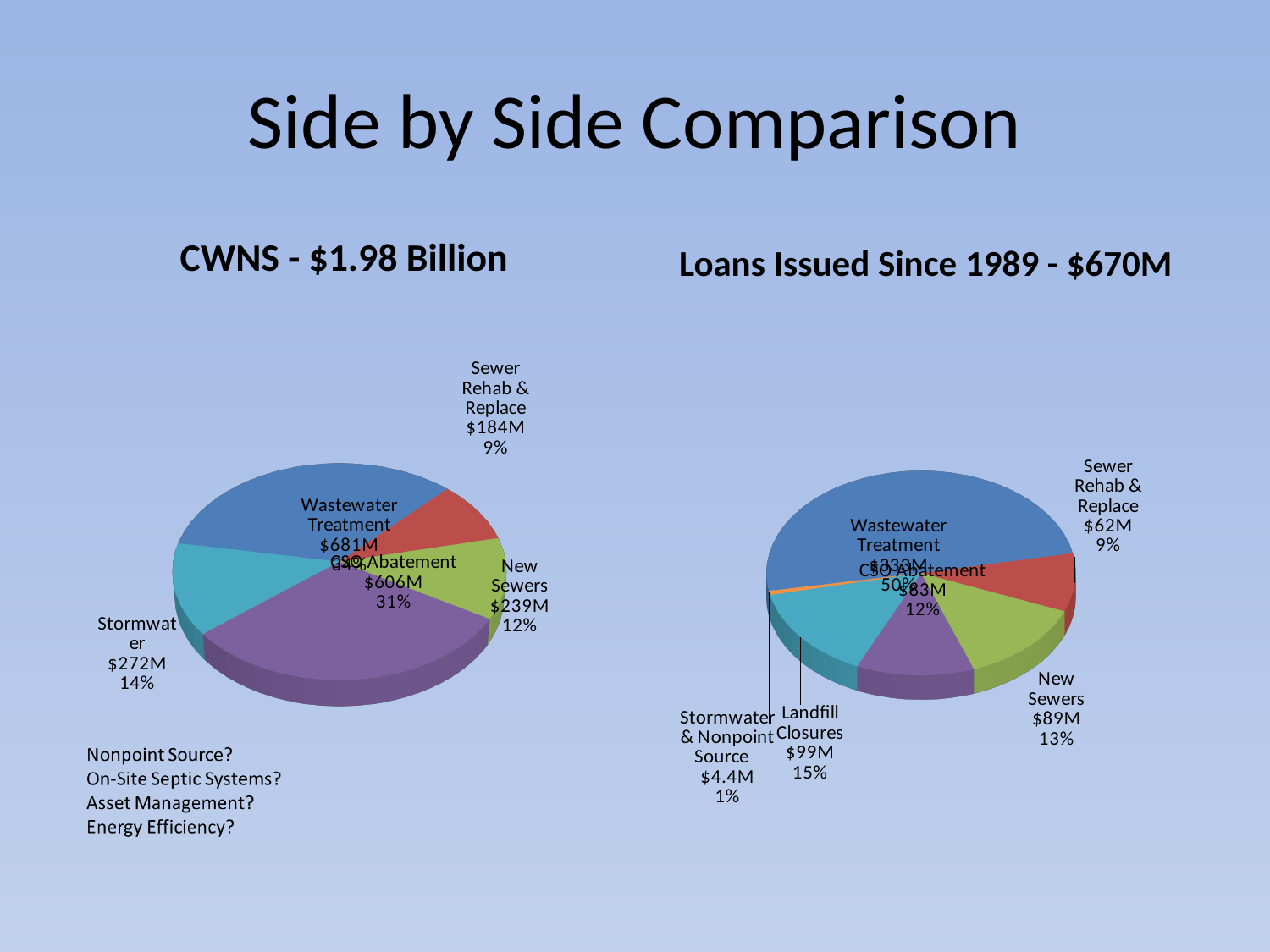
What is the difference between the Sewer Rehab & Replace value in the 'CWNS - $1.98 Billion' chart and the Sewer Rehab & Replace value in the 'Loans Issued Since 1989 - $670M' chart? $122M In the 'CWNS - $1.98 Billion' chart, what is the value for Stormwater? $272M In the 'Loans Issued Since 1989 - $670M' chart, which category has the smallest slice? Stormwater & Nonpoint Source In the 'CWNS - $1.98 Billion' chart, what share of the pie is CSO Abatement? 31% How many slices does the 'CWNS - $1.98 Billion' pie chart have? 5 In the 'CWNS - $1.98 Billion' chart, which category has the smallest slice? Sewer Rehab & Replace What kind of chart is the 'CWNS - $1.98 Billion' chart? pie chart In the 'Loans Issued Since 1989 - $670M' chart, what share of the pie is New Sewers? 13% In the 'CWNS - $1.98 Billion' chart, which is larger, CSO Abatement or Stormwater? CSO Abatement In the 'Loans Issued Since 1989 - $670M' chart, what is the value for Landfill Closures? $99M In the 'Loans Issued Since 1989 - $670M' chart, which category has the largest slice? Wastewater Treatment In the 'CWNS - $1.98 Billion' chart, what is the value for New Sewers? $239M